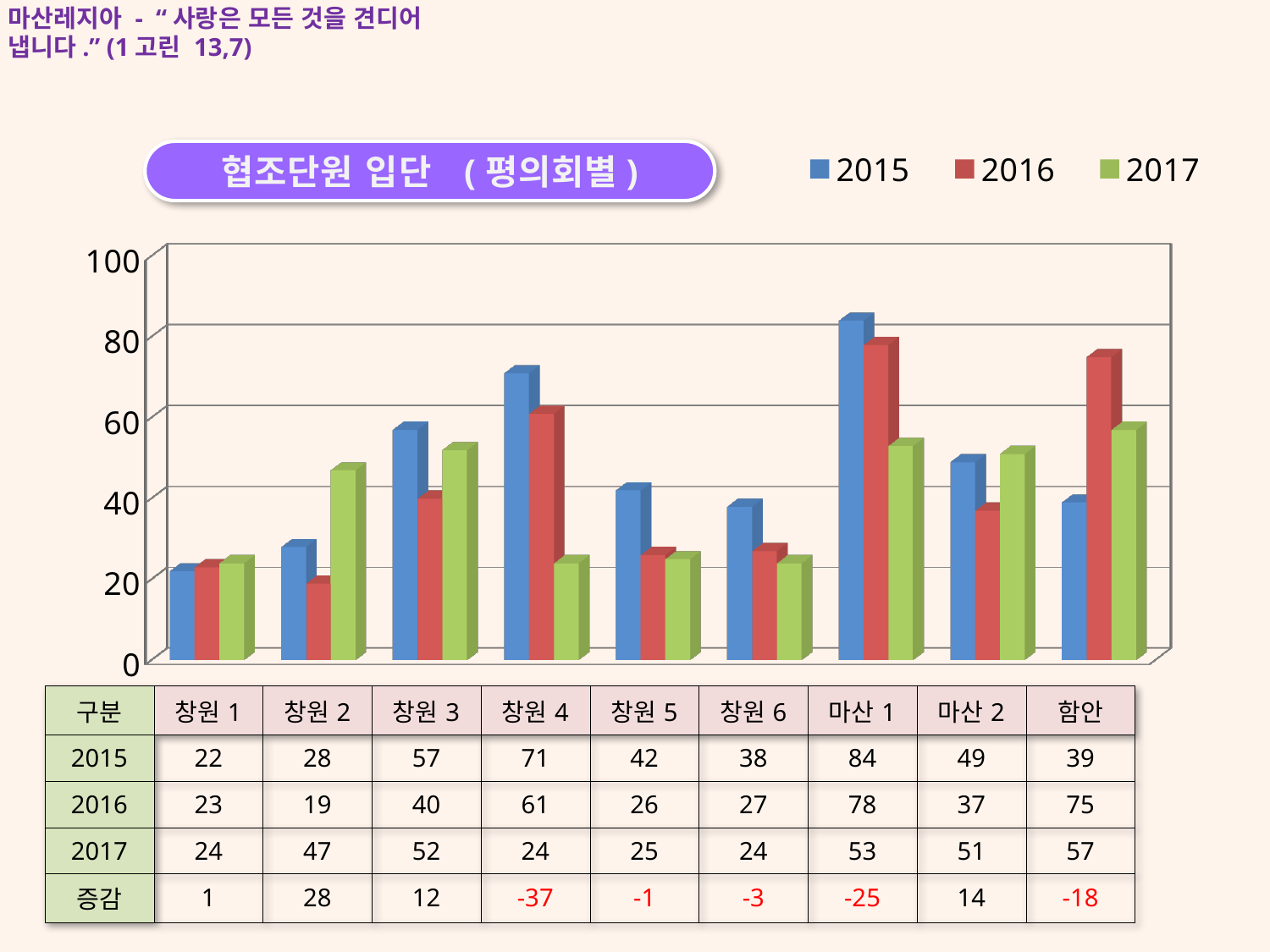
What kind of chart is shown on the slide? bar chart Which colour represents the 2017 series in the legend? green What is the difference between the 2015 and 2017 values for 창원 4? 47 What is the 2017 value for 창원 2? 47 Which category has the lowest 2016 value? 창원 2 Which category has the highest 2015 value? 마산 1 How many categories are shown on the x axis? 9 Which is larger for 함안: the 2016 value or the 2015 value? 2016 What is the 2016 value for 함안? 75 What is the 2015 value for 마산 1? 84 How many series does the legend list? 3 Is the 2015 value for 마산 1 greater or less than 80? greater